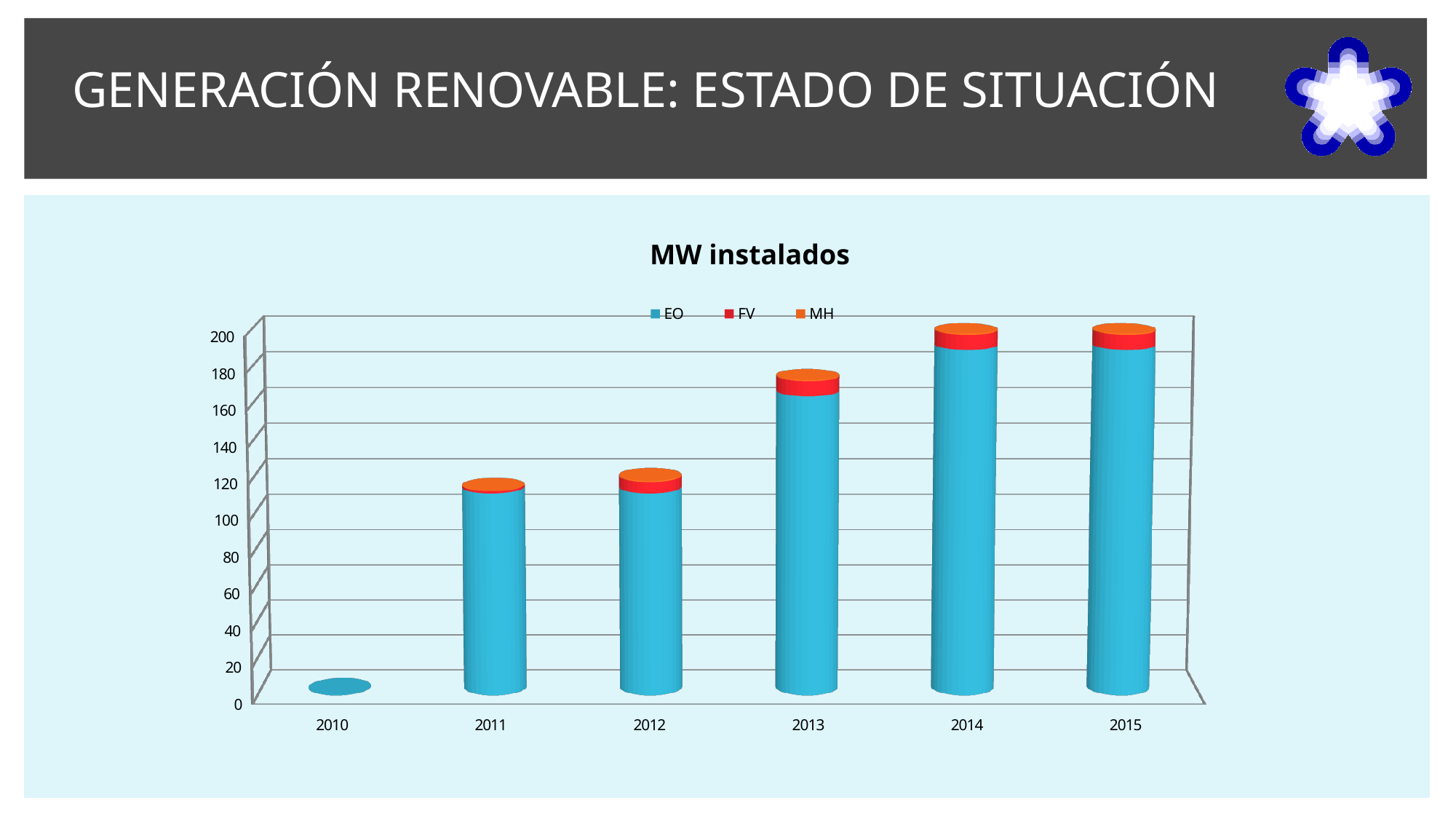
Is the total value for 2012 greater or less than 140? less Is the total value for 2011 greater or less than 100? greater What kind of chart is shown on the slide? bar chart Do the total values generally rise or fall from 2010 to 2015? rise What is the title of the chart? MW instalados How many years are shown on the x axis? 6 Which year has a larger total, 2012 or 2013? 2013 Which year has the lowest total MW instalados? 2010 Which series are listed in the legend? EO, FV, MH How many series does the legend list? 3 Is the total value for 2010 greater or less than 20? less